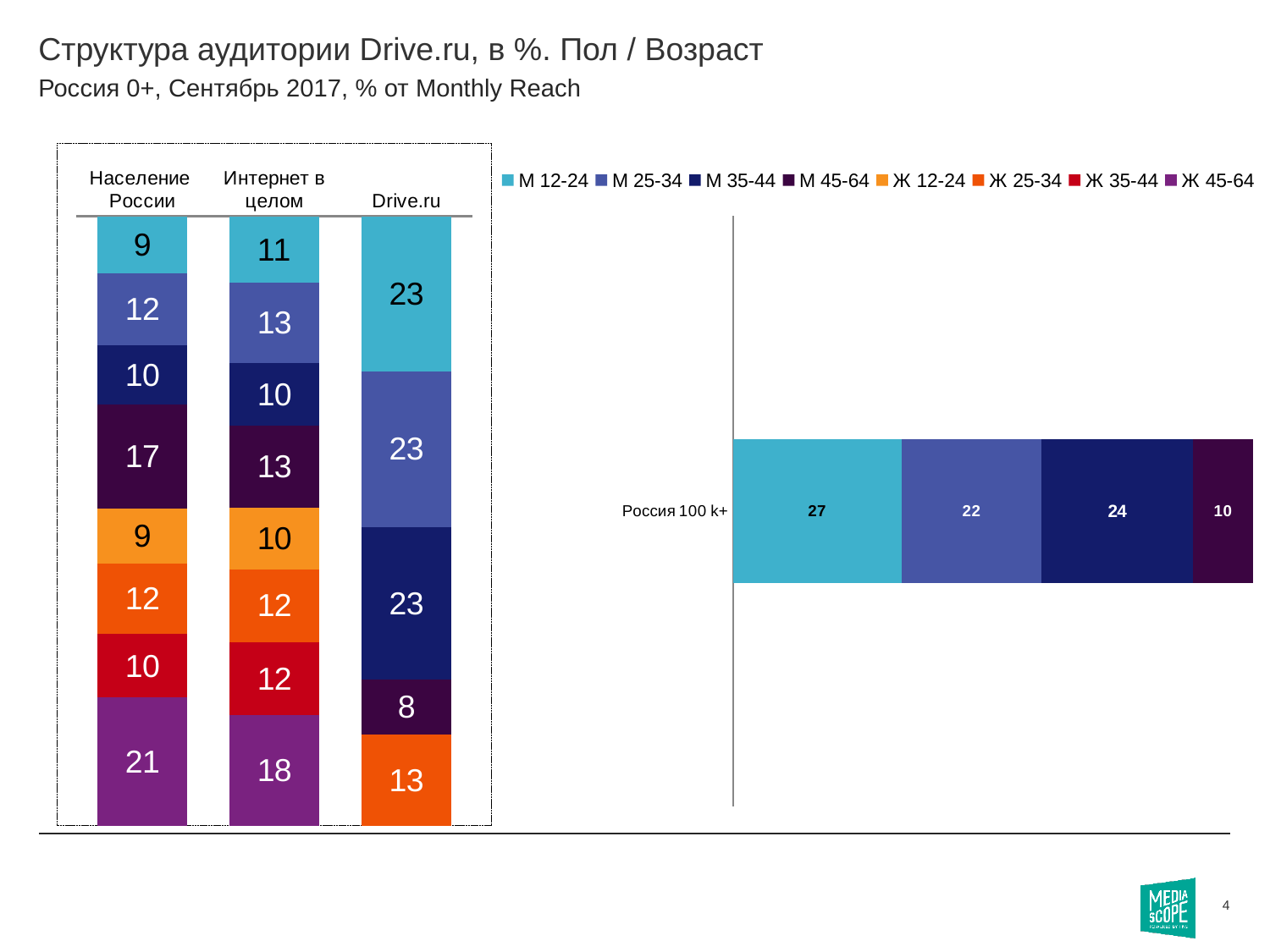
What kind of chart is the right chart? Stacked bar chart In the right chart, which segment of the Россия 100 k+ bar has the smallest value? М 45-64 In the left chart, which is larger for Drive.ru: the М 45-64 segment or the Ж 25-34 segment? Ж 25-34 In the left chart, what is the value of the М 45-64 segment for Интернет в целом? 13 How many bars are in the left chart? 3 In the left chart, what is the value of the М 12-24 segment for Drive.ru? 23 In the left chart, which segment of the Население России bar has the largest value? Ж 45-64 How many series does the legend list? 8 In the right chart, what is the value of the М 12-24 segment for Россия 100 k+? 27 In the right chart, what is the difference between the М 12-24 and М 45-64 values for Россия 100 k+? 17 In the left chart, what is the difference between the Ж 45-64 values for Население России and Интернет в целом? 3 In the left chart, what is the value of the Ж 45-64 segment for Население России? 21